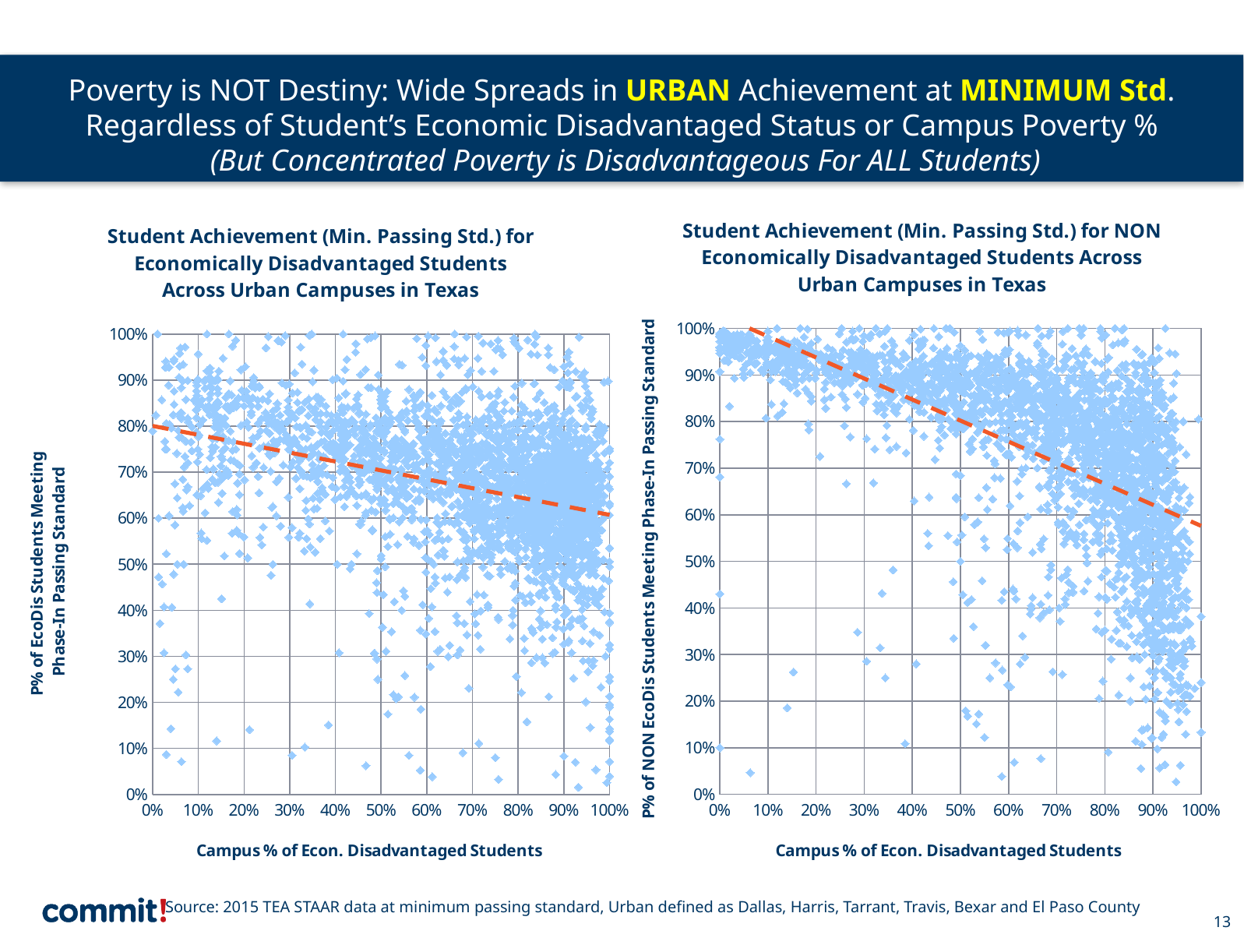
In the right chart, what is the lowest value shown on the x-axis? 0% In the right chart, does the dashed trend line rise or fall as Campus % of Econ. Disadvantaged Students increases? fall How many charts are shown on the slide? 2 What is the x-axis label of the left chart? Campus % of Econ. Disadvantaged Students In the left chart, does the dashed trend line rise or fall as Campus % of Econ. Disadvantaged Students increases? fall What kind of chart is the right chart, titled 'Student Achievement (Min. Passing Std.) for NON Economically Disadvantaged Students Across Urban Campuses in Texas'? scatter chart What kind of chart is the left chart, titled 'Student Achievement (Min. Passing Std.) for Economically Disadvantaged Students Across Urban Campuses in Texas'? scatter chart In the left chart, is the dashed trend line at 0% campus poverty greater or less than 70%? greater In the right chart, is the dashed trend line at 0% campus poverty greater or less than 90%? greater In the left chart, what is the highest value shown on the y-axis? 100% In the left chart, is the dashed trend line at 100% campus poverty greater or less than 70%? less What is the y-axis label of the right chart? P% of NON EcoDis Students Meeting Phase-In Passing Standard